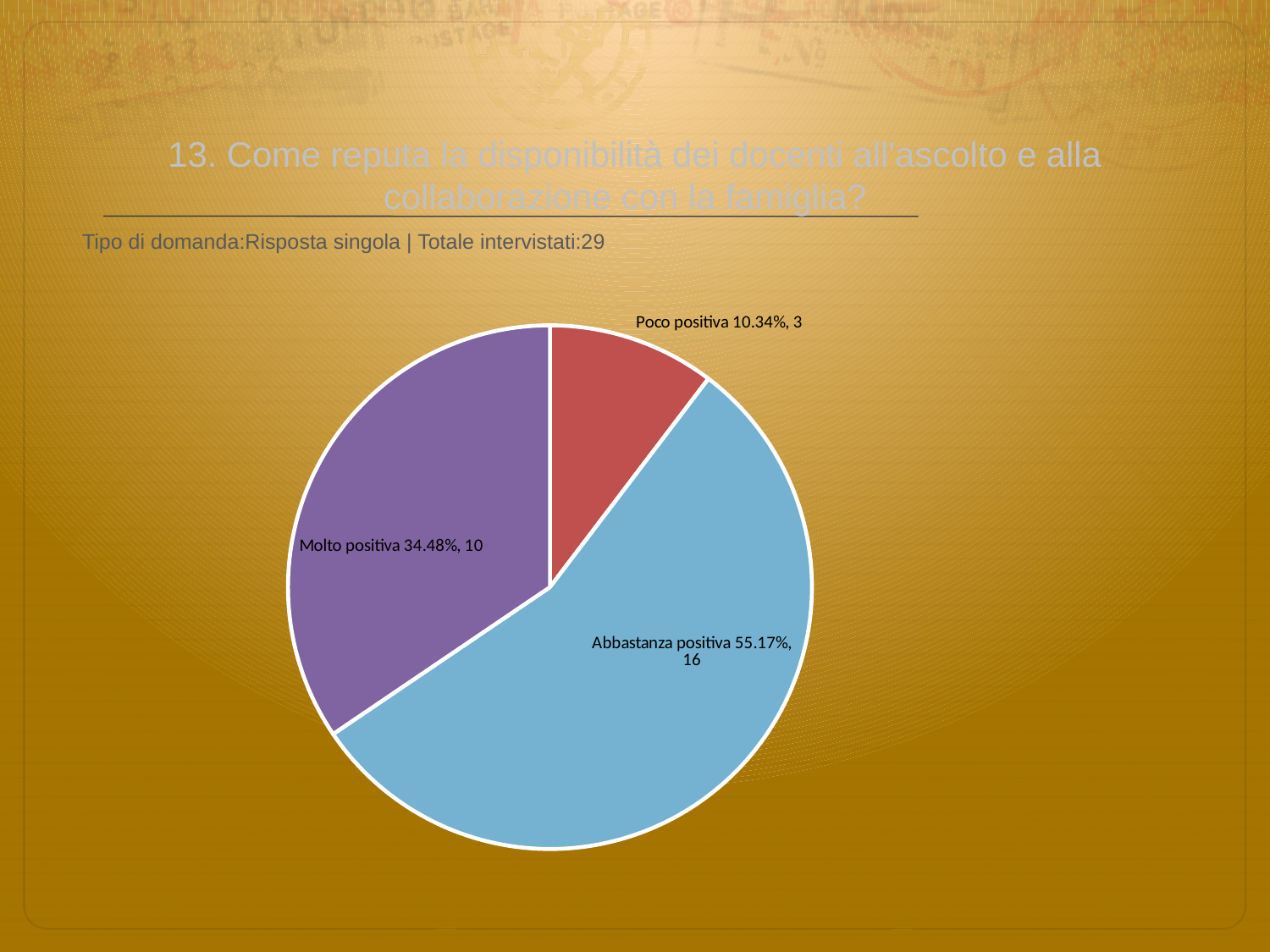
What percentage share does the 'Poco positiva' slice have? 10.34% How many respondents answered 'Abbastanza positiva'? 16 How many respondents answered 'Poco positiva'? 3 What type of chart is shown on the slide? pie chart How many slices does the pie chart have? 3 Which category has the largest slice of the pie? Abbastanza positiva What percentage share does the 'Abbastanza positiva' slice have? 55.17% Which category has the smallest slice of the pie? Poco positiva Which has more respondents, 'Molto positiva' or 'Poco positiva'? Molto positiva How many respondents answered 'Molto positiva'? 10 What percentage share does the 'Molto positiva' slice have? 34.48% What is the difference in respondent count between 'Abbastanza positiva' and 'Molto positiva'? 6